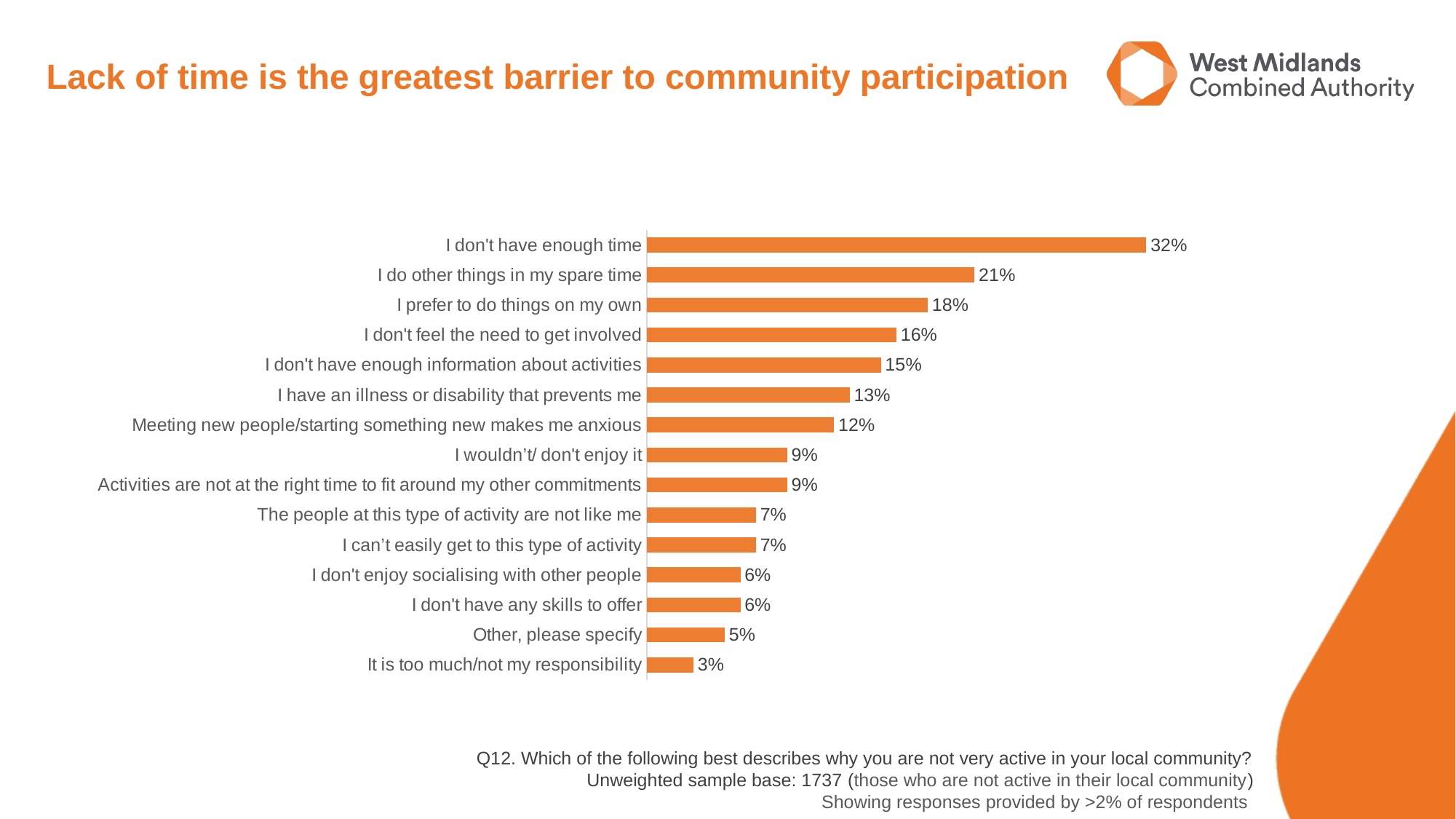
Which barrier has the lowest percentage? It is too much/not my responsibility What is the difference between "I don't have enough time" and "I do other things in my spare time"? 11 percentage points Which barrier has the highest percentage? I don't have enough time What type of chart is shown on the slide? Bar chart What is the value for "I have an illness or disability that prevents me"? 13% Which is larger: "I don't have enough information about activities" or "Meeting new people/starting something new makes me anxious"? I don't have enough information about activities What percentage is shown for "Other, please specify"? 5% How many barriers (categories) are shown in the chart? 15 What is the unweighted sample base stated below the chart? 1737 What is the difference between "I prefer to do things on my own" and "I don't feel the need to get involved"? 2 percentage points What percentage of respondents said "I don't have enough time"? 32% What colour are the bars in the chart? Orange